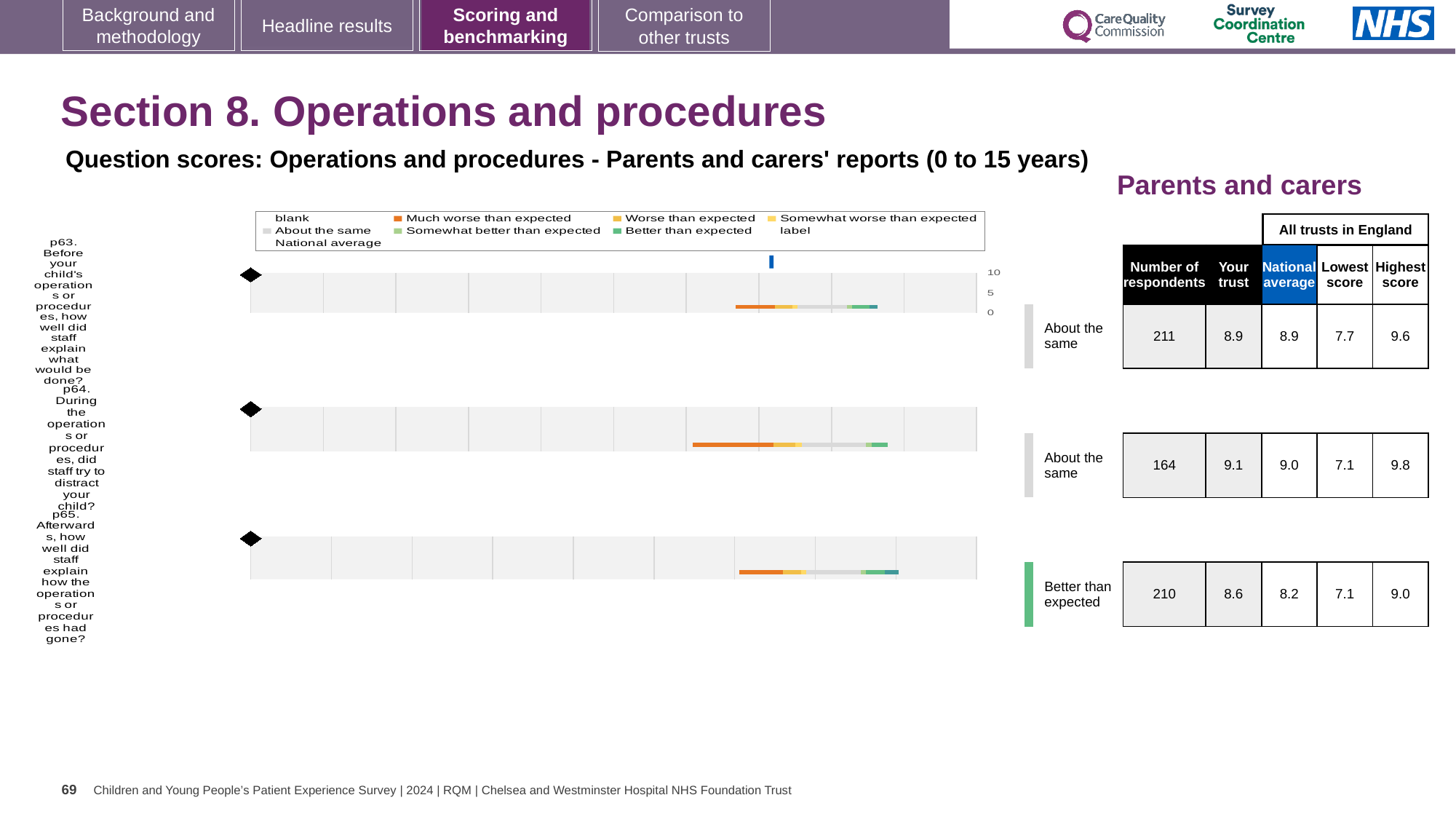
How many respondents answered p63 (Before your child's operations or procedures, how well did staff explain what would be done?)? 211 For p64, what is the difference between the highest score and the lowest score across all trusts in England? 2.7 For p65, how much higher is the 'Your trust' score than the national average? 0.4 What is the highest score among all trusts in England for p64? 9.8 Which question has the lowest 'Your trust' score? p65 Which question has the highest 'Your trust' score? p64 What is the lowest score among all trusts in England for p63? 7.7 What benchmark category is shown for p65? Better than expected How many questions are shown on the slide? 3 Which has the larger 'Your trust' score, p64 or p65? p64 What is the 'Your trust' score for p64 (During the operations or procedures, did staff try to distract your child?)? 9.1 What is the national average score for p65 (Afterwards, how well did staff explain how the operations or procedures had gone?)? 8.2